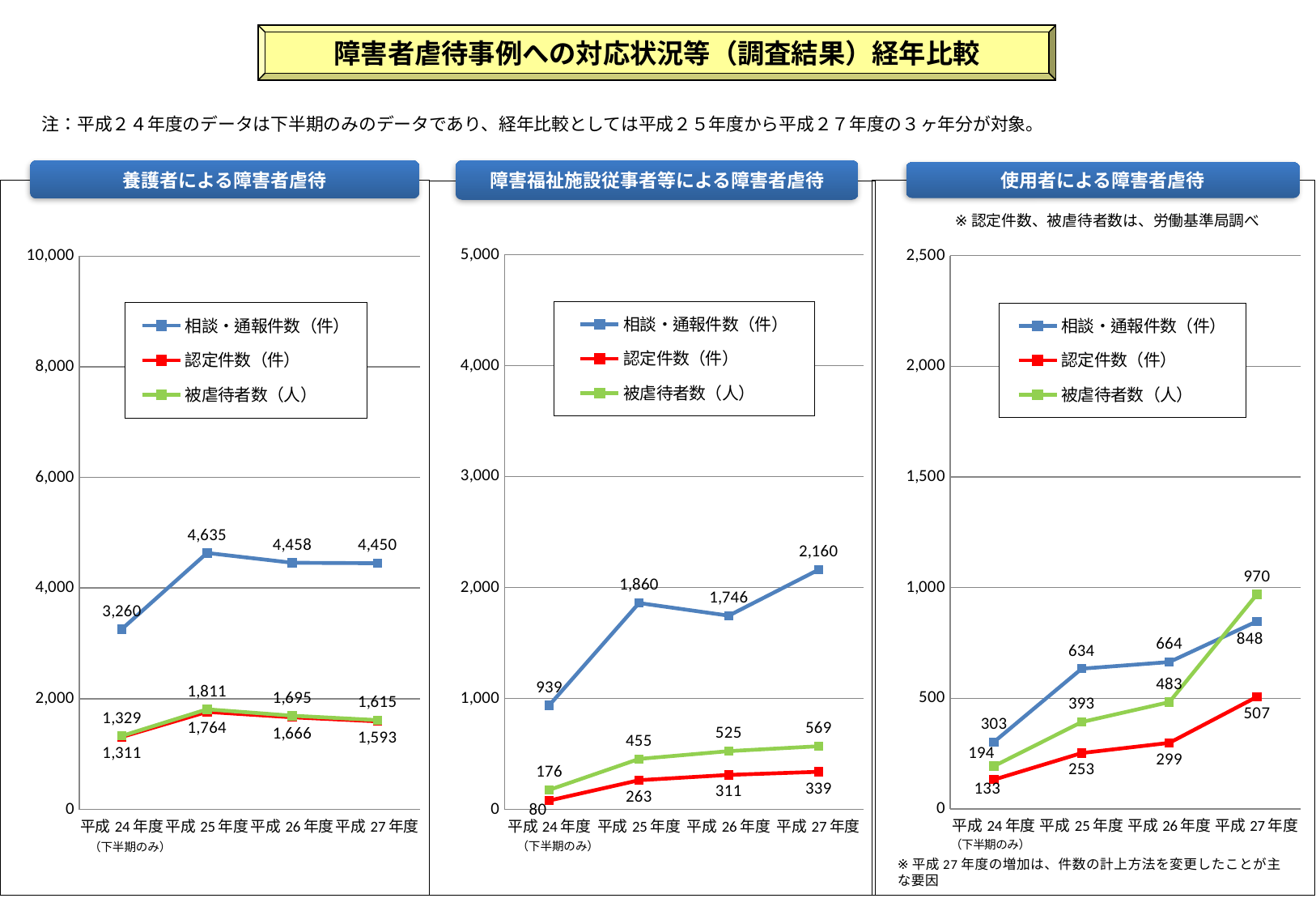
In the 使用者による障害者虐待 chart, which year has the lowest 認定件数? 平成24年度 In the 使用者による障害者虐待 chart, what is the difference in 認定件数 between 平成27年度 and 平成26年度? 208 In the 使用者による障害者虐待 chart, which is larger in 平成27年度, 相談・通報件数 or 被虐待者数? 被虐待者数 In the 障害福祉施設従事者等による障害者虐待 chart, what is the 相談・通報件数 value for 平成27年度? 2,160 In the 使用者による障害者虐待 chart, what is the 被虐待者数 value for 平成27年度? 970 In the 障害福祉施設従事者等による障害者虐待 chart, what is the 認定件数 value for 平成24年度? 80 In the 養護者による障害者虐待 chart, what is the 相談・通報件数 value for 平成25年度? 4,635 How many series does the legend of the 養護者による障害者虐待 chart list? 3 What kind of chart is the 障害福祉施設従事者等による障害者虐待 chart? line chart In the 養護者による障害者虐待 chart, what is the difference between 被虐待者数 and 認定件数 in 平成27年度? 22 In the 障害福祉施設従事者等による障害者虐待 chart, does the 被虐待者数 series rise or fall from 平成24年度 to 平成27年度? rise In the 養護者による障害者虐待 chart, which year has the highest 相談・通報件数? 平成25年度